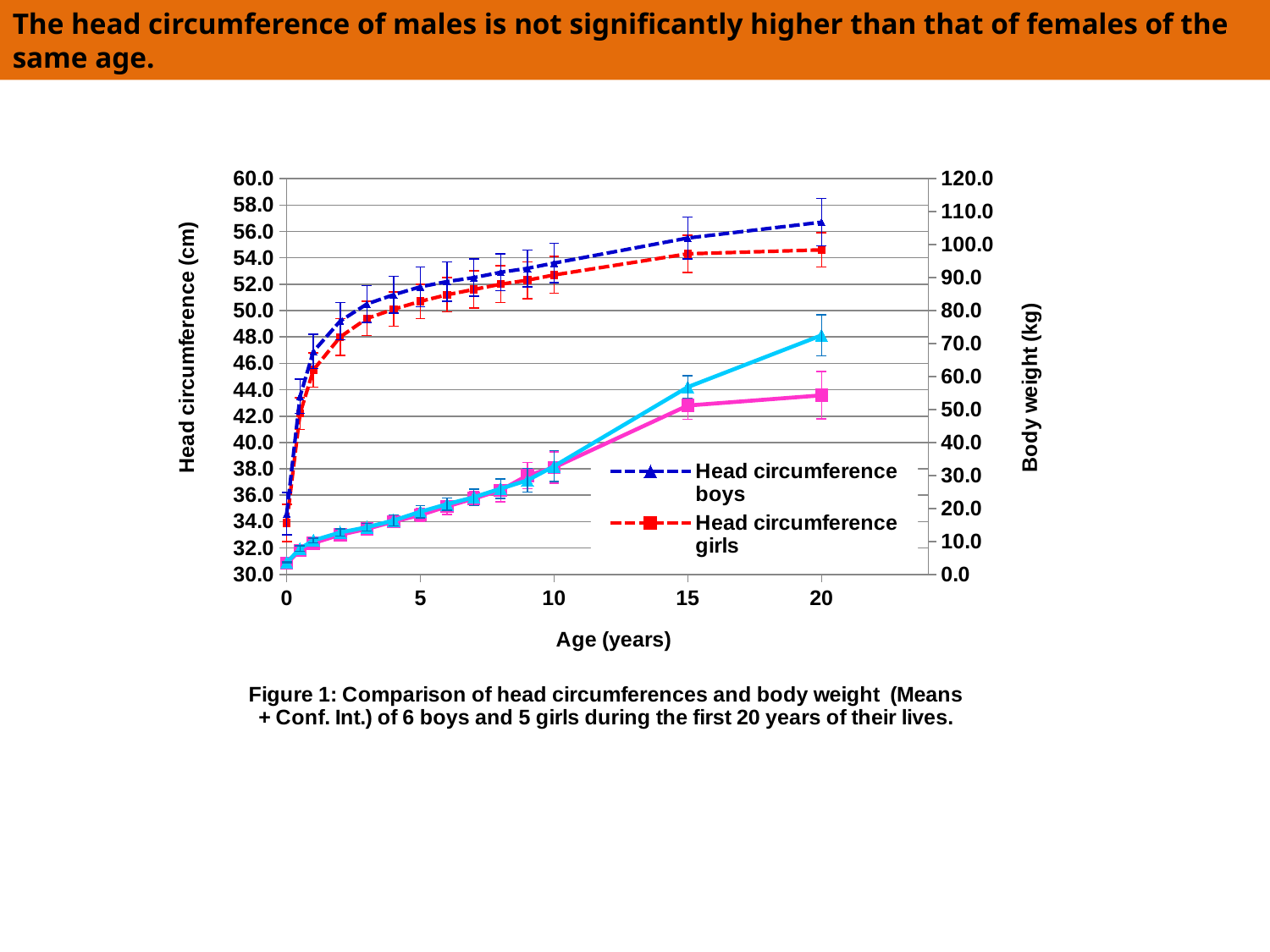
Is the head circumference of girls at age 2 greater or less than 50.0 cm? less At age 15, which is larger: the head circumference of boys or of girls? boys What kind of chart is shown on the slide? line chart Is the head circumference of girls at age 20 greater or less than 56.0 cm? less Does the head circumference of girls rise or fall as age increases? rise What is the title of the x axis of the chart? Age (years) Is the head circumference of boys at age 10 greater or less than 52.0 cm? greater How many series does the chart's legend list? 2 Does the head circumference of boys rise or fall as age increases? rise What is the title of the right-hand y axis of the chart? Body weight (kg) At age 20, which is larger: the head circumference of boys or of girls? boys